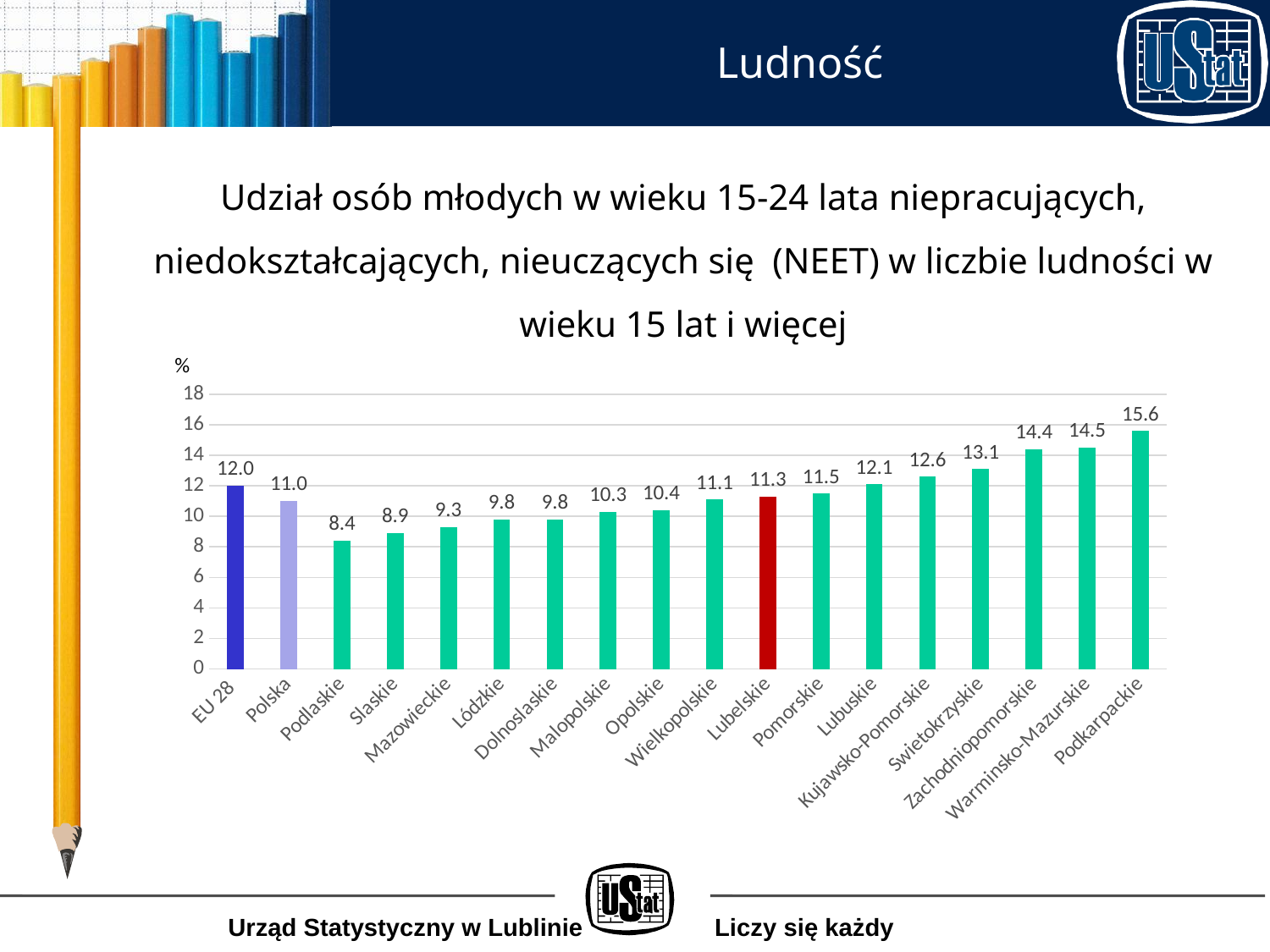
What is the value for Kujawsko-Pomorskie? 12.6 Which category has the highest value? Podkarpackie Which is larger, the value for Lubelskie or the value for Polska? Lubelskie What is the value for Lubelskie? 11.3 What unit is shown on the vertical axis of the chart? % What kind of chart is shown on the slide? bar chart What is the value for EU 28? 12.0 How many categories are shown on the x axis? 18 Which category has the lowest value? Podlaskie What is the value for Polska? 11.0 Is the value for Swietokrzyskie greater or less than 12? greater What is the difference between the values for Podkarpackie and Podlaskie? 7.2